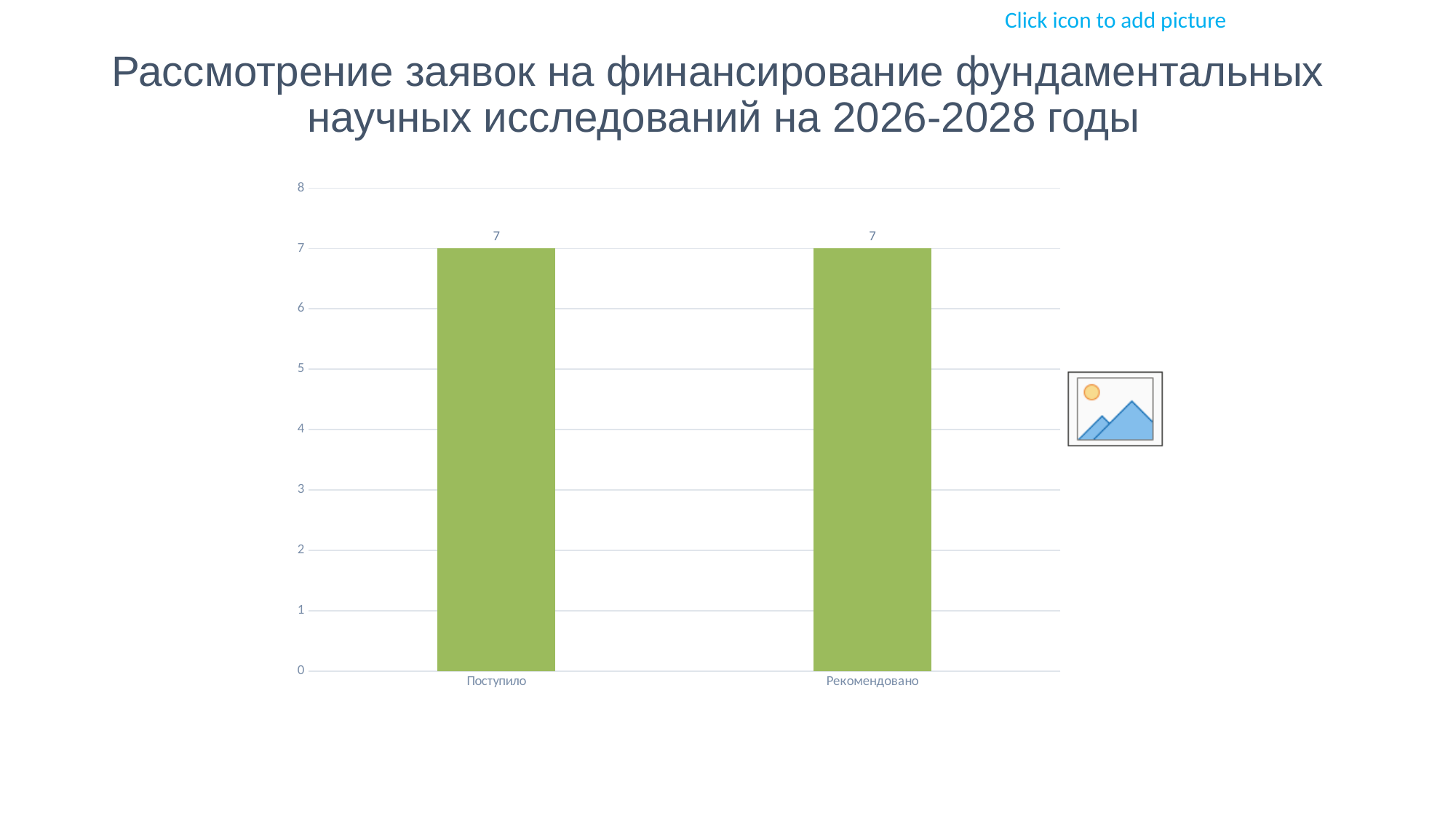
Do the values rise, fall, or stay the same from Поступило to Рекомендовано? stay the same Is the value for Рекомендовано greater or less than 8? less What is the highest value shown on the vertical axis? 8 How many categories are shown on the x axis? 2 What kind of chart is shown on the slide? bar chart What is the value for Рекомендовано? 7 What colour are the bars in the chart? green What is the difference between the values for Поступило and Рекомендовано? 0 Is the value for Рекомендовано larger than, smaller than, or equal to the value for Поступило? equal What is the value for Поступило? 7 Is the value for Поступило greater or less than 5? greater